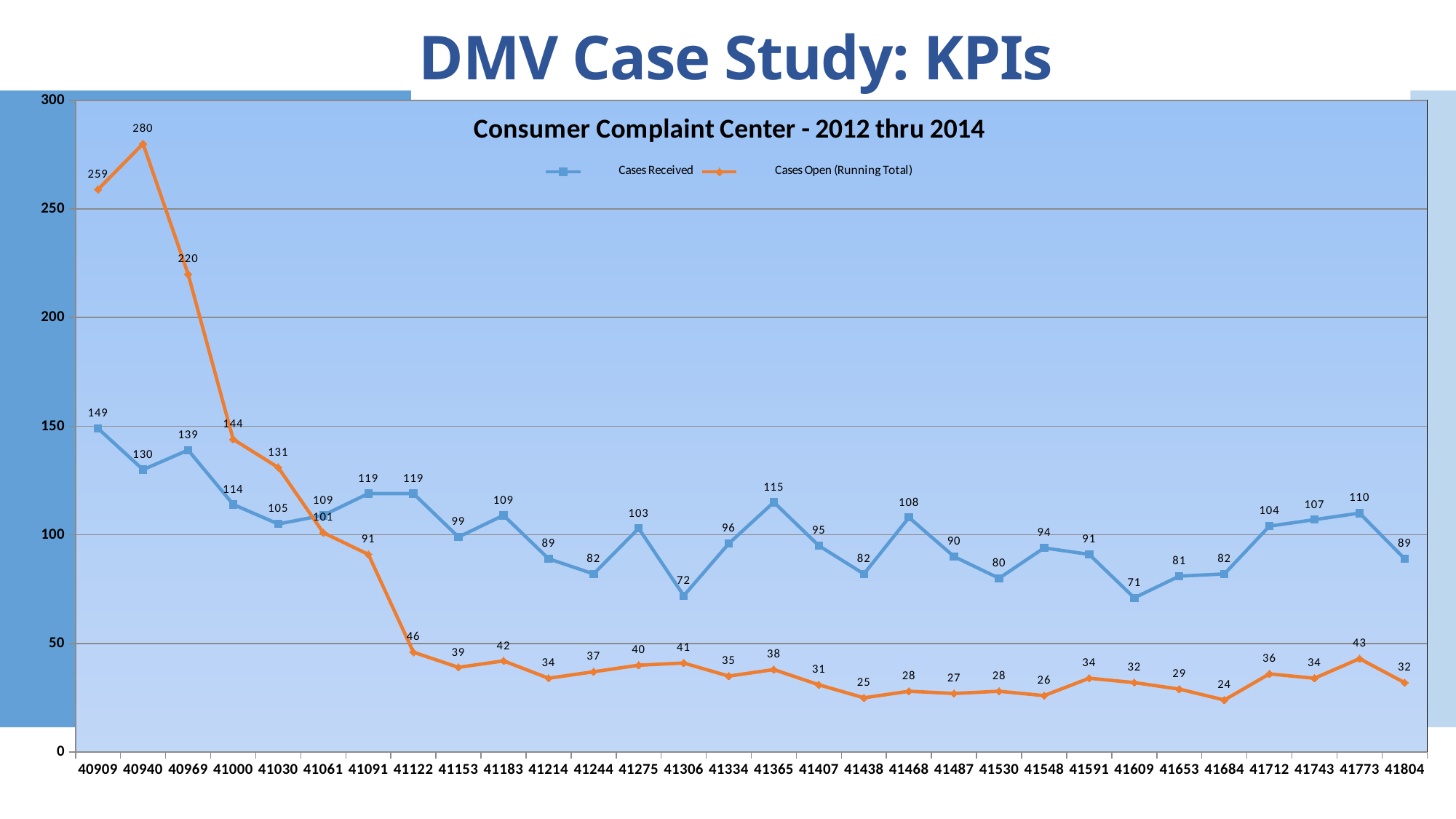
Does Cases Open (Running Total) generally rise or fall from 40940 to 41122? fall At which x-axis point is Cases Received at its lowest? 41609 What is the value of Cases Received at 40909? 149 At which x-axis point does Cases Open (Running Total) reach its highest value? 40940 What is the lowest value of Cases Open (Running Total)? 24 How many series does the legend list? 2 What is the difference between Cases Received and Cases Open (Running Total) at 41804? 57 Which is larger at 40969: Cases Received or Cases Open (Running Total)? Cases Open (Running Total) What is the value of Cases Open (Running Total) at 41122? 46 What type of chart is shown on the slide? line chart What is the title of the chart? Consumer Complaint Center - 2012 thru 2014 How many x-axis points are plotted on the chart? 30